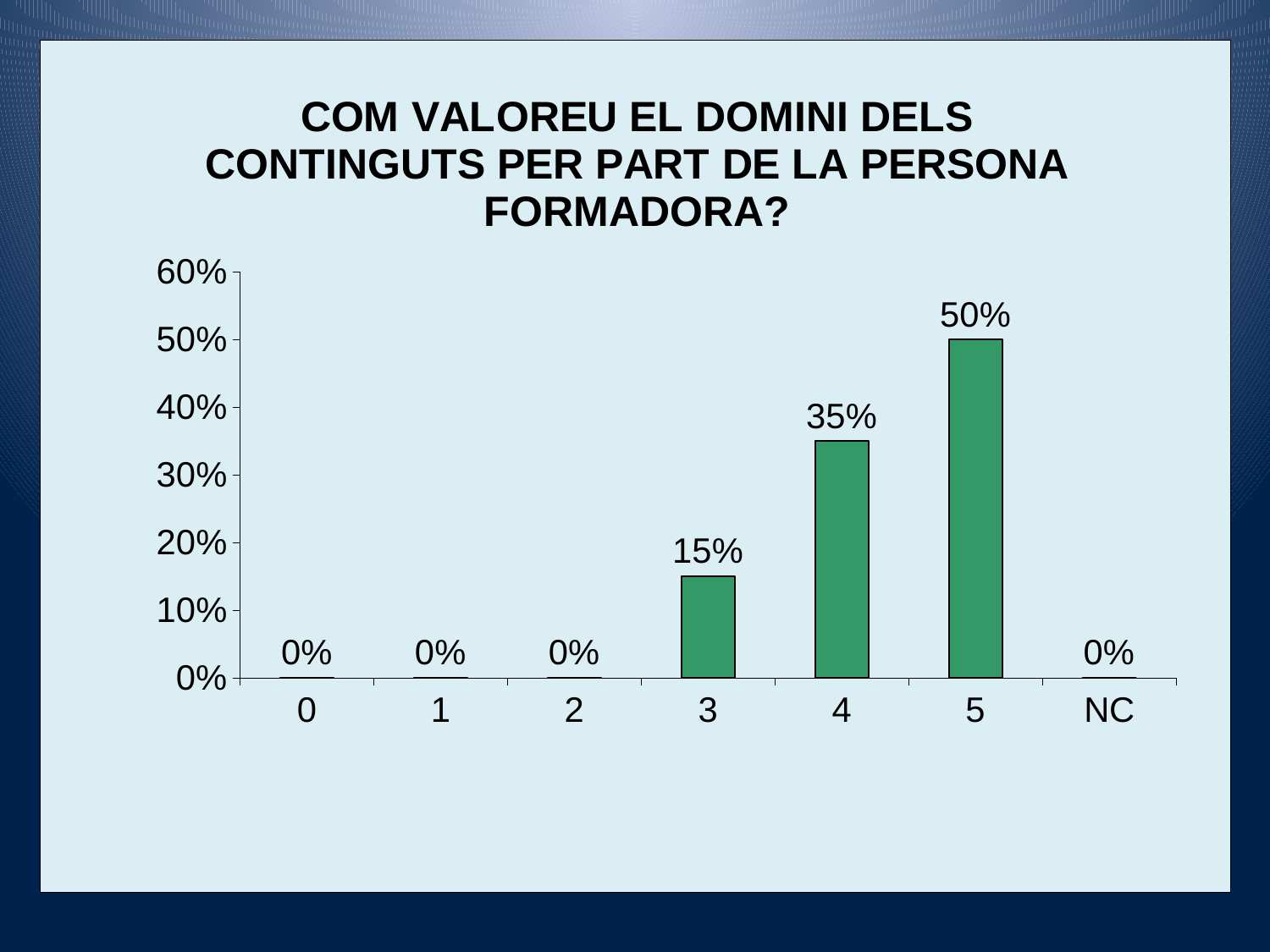
What is the difference between the values for categories 5 and 4? 15% How many categories are shown on the x axis? 7 What is the difference between the values for categories 4 and 3? 20% Which category has the highest value? 5 Do the values rise or fall from category 3 to category 5? rise What is the title of the chart? COM VALOREU EL DOMINI DELS CONTINGUTS PER PART DE LA PERSONA FORMADORA? What is the value for category 4? 35% What is the value for category 3? 15% What is the value for the NC category? 0% What kind of chart is shown on the slide? bar chart What is the value for category 5? 50% Which is larger, the value for category 3 or the value for category 4? 4